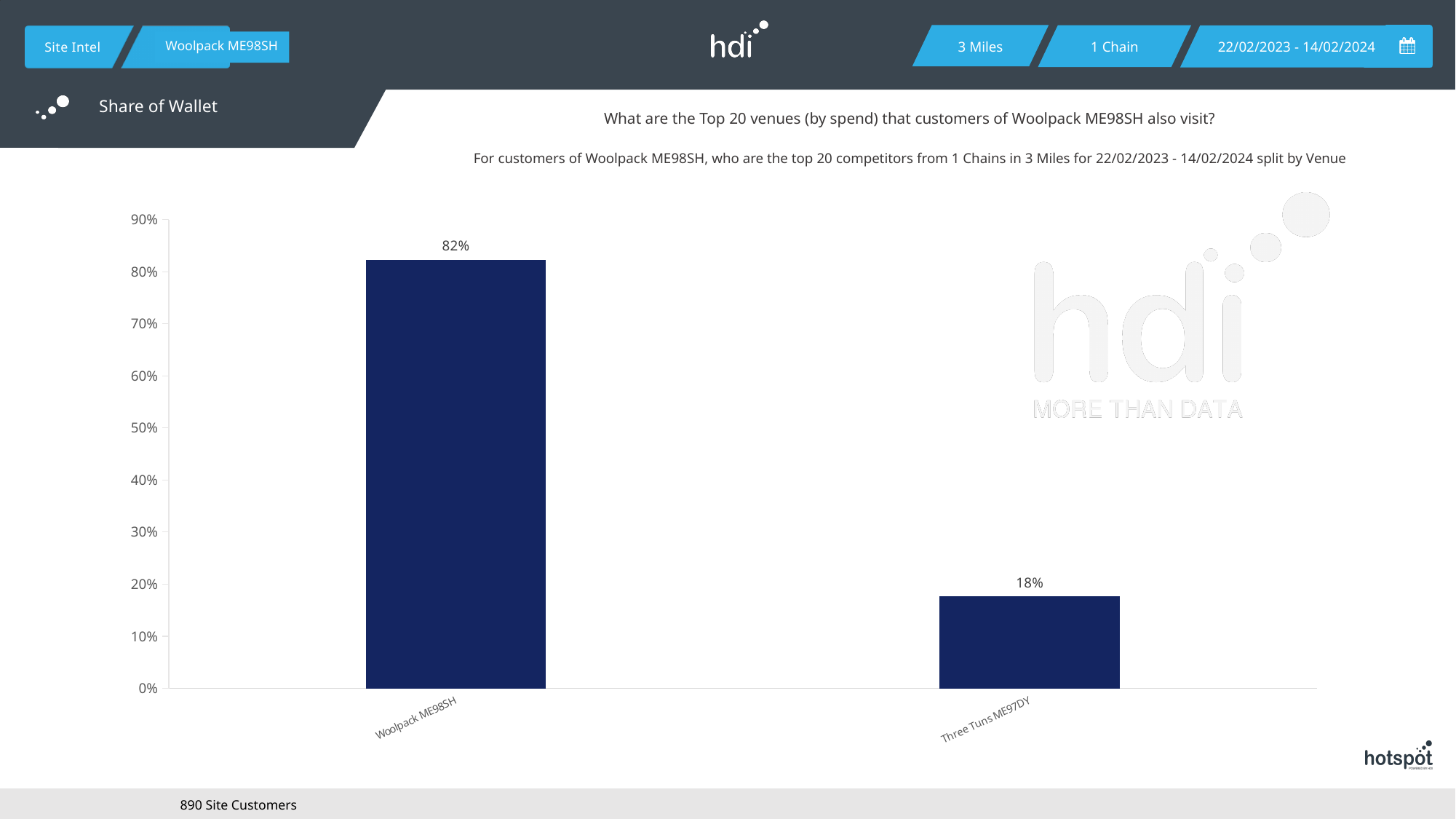
How many site customers are noted at the bottom of the slide? 890 Site Customers What is the difference between the values for Woolpack ME98SH and Three Tuns ME97DY? 64% What is the total of the two values shown on the chart? 100% How many venues are shown on the chart? 2 What is the value for Woolpack ME98SH? 82% Is the value for Woolpack ME98SH greater or less than 80%? greater What is the value for Three Tuns ME97DY? 18% Is the value for Three Tuns ME97DY greater or less than 20%? less Which is larger, the value for Woolpack ME98SH or Three Tuns ME97DY? Woolpack ME98SH Which venue has the highest value? Woolpack ME98SH Which venue has the lowest value? Three Tuns ME97DY What kind of chart is shown on the slide? Bar chart